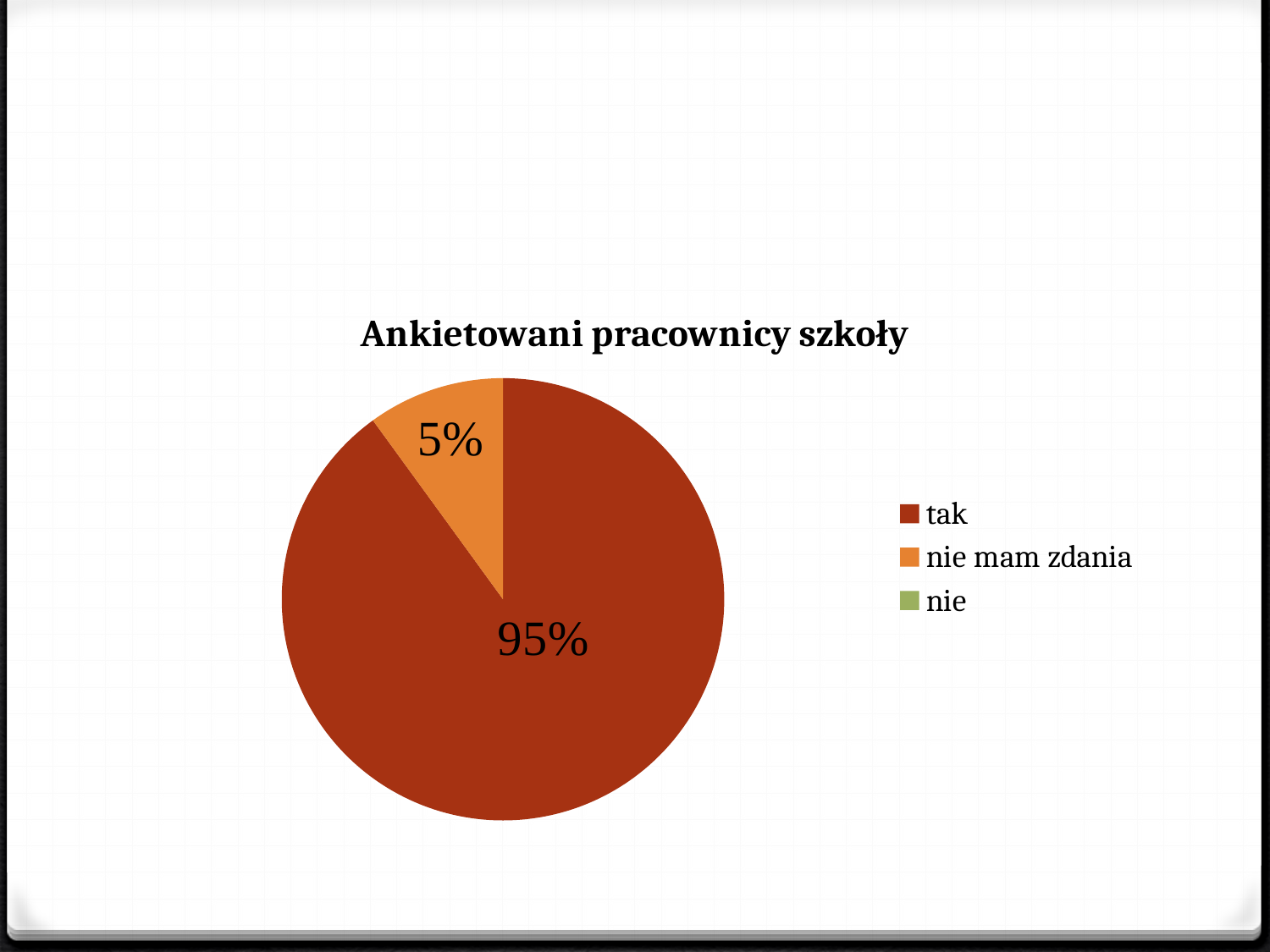
What share of the pie does "nie mam zdania" take? 5% What colour is the slice for "nie mam zdania"? orange What is the title of the chart? Ankietowani pracownicy szkoły Is the share for "tak" greater or less than 50%? greater What share of the pie does "tak" take? 95% How many entries does the legend list? 3 What is the difference between the share for "tak" and the share for "nie mam zdania"? 90% Which is larger, the slice for "tak" or the slice for "nie mam zdania"? tak Which category has the largest slice of the pie? tak What kind of chart is shown on the slide? pie chart